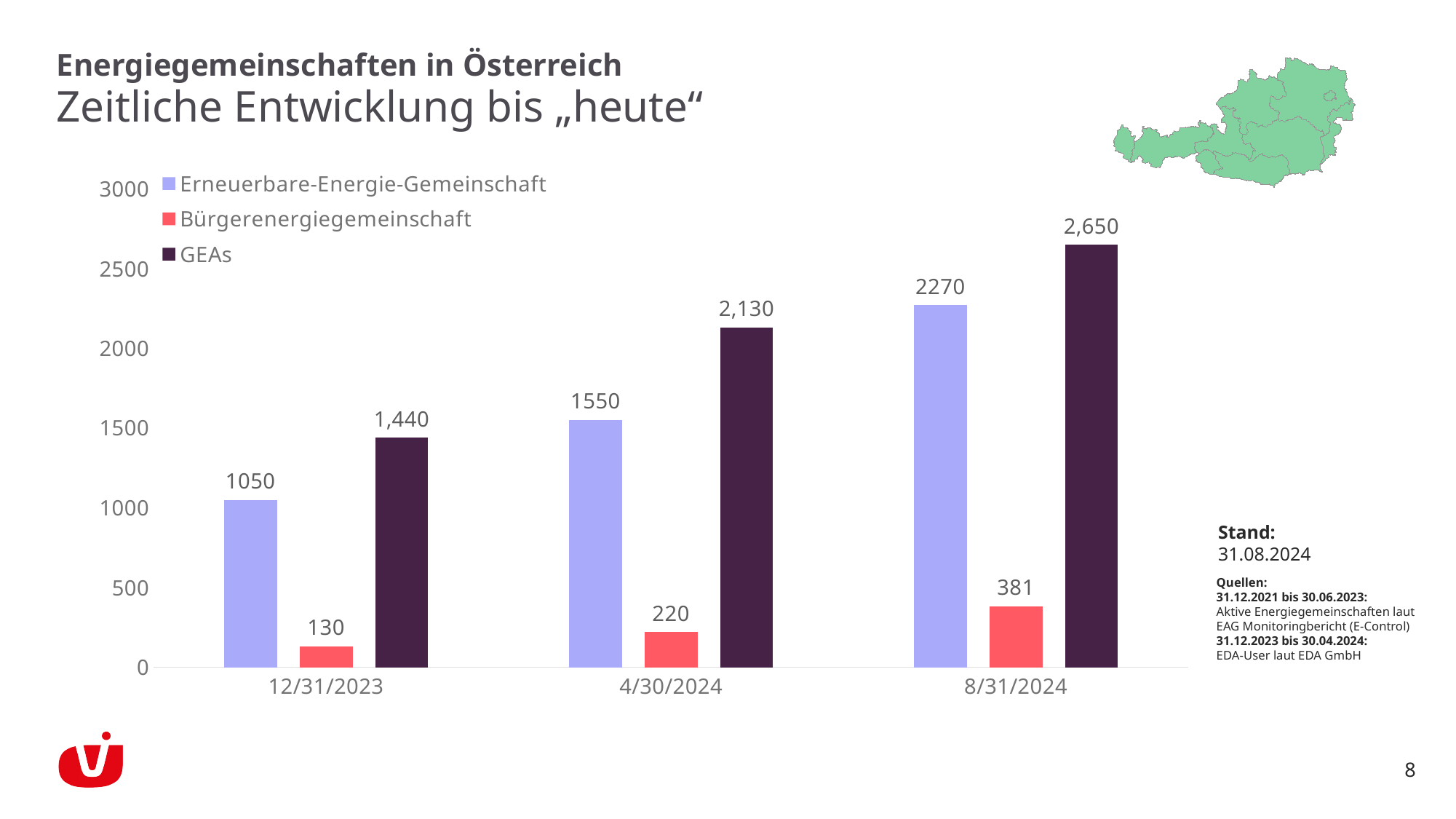
On which date is the Erneuerbare-Energie-Gemeinschaft value lowest? 12/31/2023 What is the value for GEAs on 8/31/2024? 2,650 On which date is the Bürgerenergiegemeinschaft value highest? 8/31/2024 Which is larger on 4/30/2024: Erneuerbare-Energie-Gemeinschaft or GEAs? GEAs How many series does the legend list? 3 What is the difference between the Erneuerbare-Energie-Gemeinschaft values on 8/31/2024 and 4/30/2024? 720 Do the GEAs values rise or fall from 12/31/2023 to 8/31/2024? Rise What is the value for GEAs on 12/31/2023? 1,440 What kind of chart is shown on the slide? Bar chart What is the value for Bürgerenergiegemeinschaft on 4/30/2024? 220 How many dates are shown on the x axis? 3 What is the value for Erneuerbare-Energie-Gemeinschaft on 12/31/2023? 1050